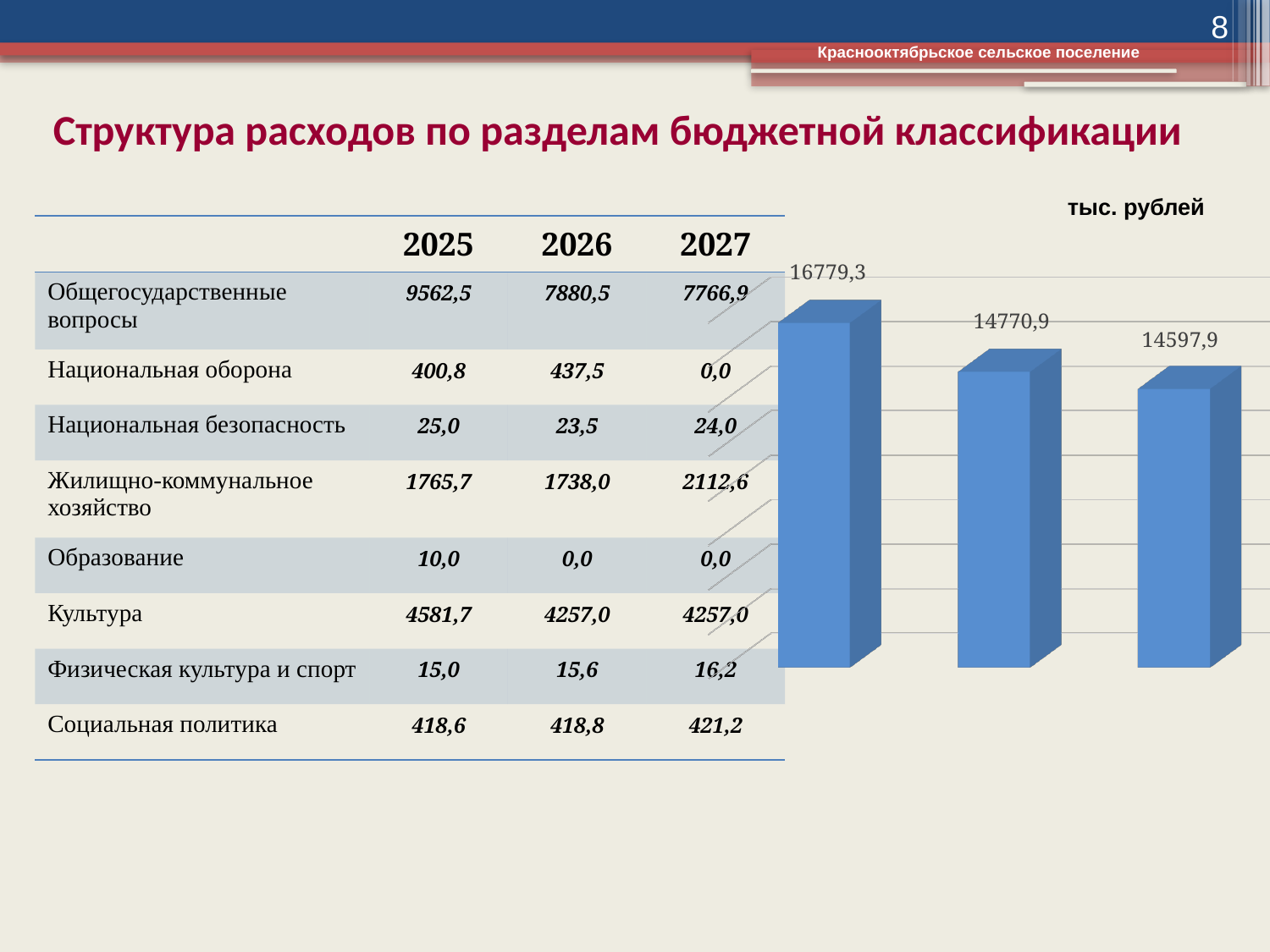
What is the value shown on the middle bar of the chart? 14770,9 How many bars are plotted in the chart? 3 What kind of chart is shown on the right side of the slide? bar chart Which bar in the chart has the highest value? the leftmost bar (16779,3) What unit label is printed above the chart? тыс. рублей What is the value shown on the rightmost bar of the chart? 14597,9 What is the difference between the leftmost bar (16779,3) and the rightmost bar (14597,9)? 2181,4 Which bar in the chart has the lowest value? the rightmost bar (14597,9) Which is larger: the value of the middle bar or the value of the rightmost bar? the middle bar (14770,9) What is the value shown on the leftmost bar of the chart? 16779,3 Do the bar values rise or fall from left to right across the chart? fall What is the difference between the leftmost bar (16779,3) and the middle bar (14770,9)? 2008,4